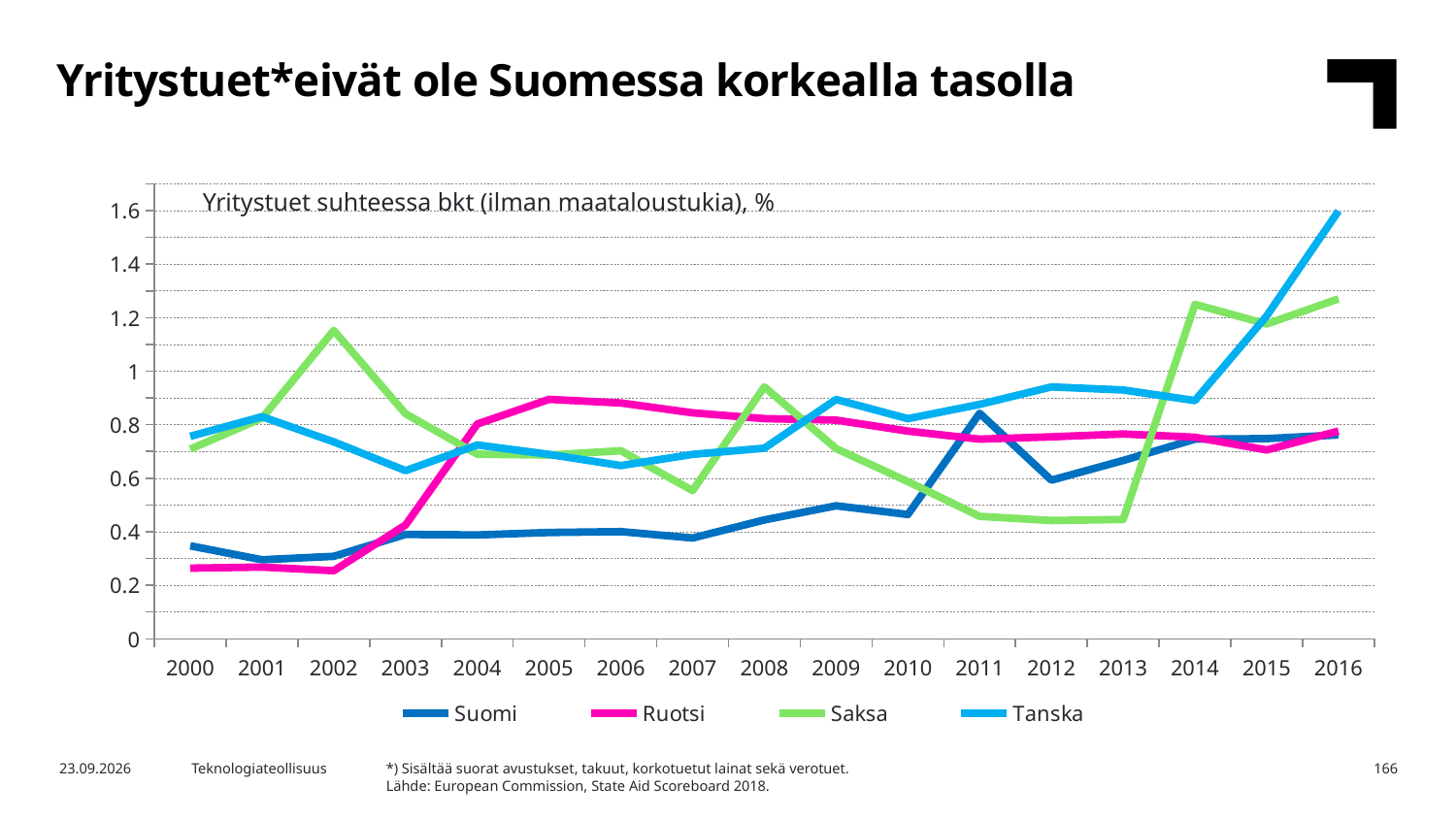
How many series does the legend list? 4 How many years are shown on the x axis? 17 Which series has the lowest value in 2013? Saksa Does the value for Suomi rise or fall overall from 2000 to 2016? rise Is the value for Suomi in 2000 greater or less than 0.4? less In 2005, which is larger: the value for Ruotsi or the value for Suomi? Ruotsi What is the title of the chart? Yritystuet suhteessa bkt (ilman maataloustukia), % Which series has the highest value in 2016? Tanska Is the value for Saksa in 2002 greater or less than 1? greater Is the value for Tanska in 2016 greater or less than 1.4? greater What kind of chart is shown on the slide? Line chart Which series has the highest value in 2002? Saksa